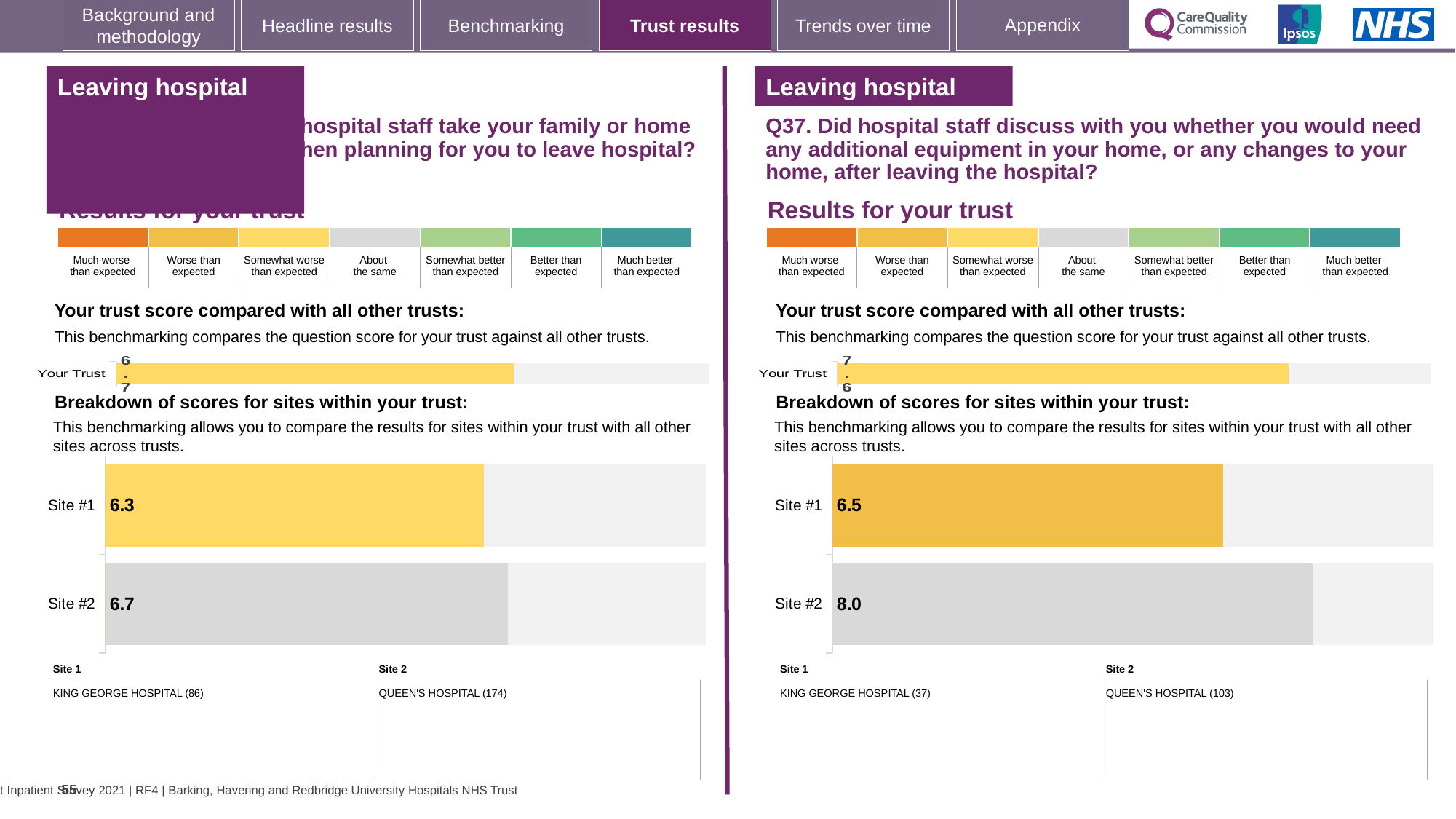
What type of chart is the left-hand site breakdown chart? Bar chart On the left-hand site breakdown chart, what is the difference between the Site #2 and Site #1 scores? 0.4 On the left-hand site breakdown chart, which site has the lower score? Site #1 On the left-hand 'Your trust score compared with all other trusts' chart, what is the score shown for Your Trust? 6.7 On the left-hand site breakdown chart, what is the score for Site #1? 6.3 On the right-hand (Q37) site breakdown chart, which site has the higher score? Site #2 How many sites are shown on the right-hand (Q37) site breakdown chart? 2 On the left-hand site breakdown chart, what is the score for Site #2? 6.7 On the right-hand (Q37) site breakdown chart, what is the score for Site #1? 6.5 On the right-hand (Q37) 'Your trust score compared with all other trusts' chart, what is the score shown for Your Trust? 7.6 On the right-hand (Q37) site breakdown chart, what is the difference between the Site #2 and Site #1 scores? 1.5 On the right-hand (Q37) site breakdown chart, what is the score for Site #2? 8.0